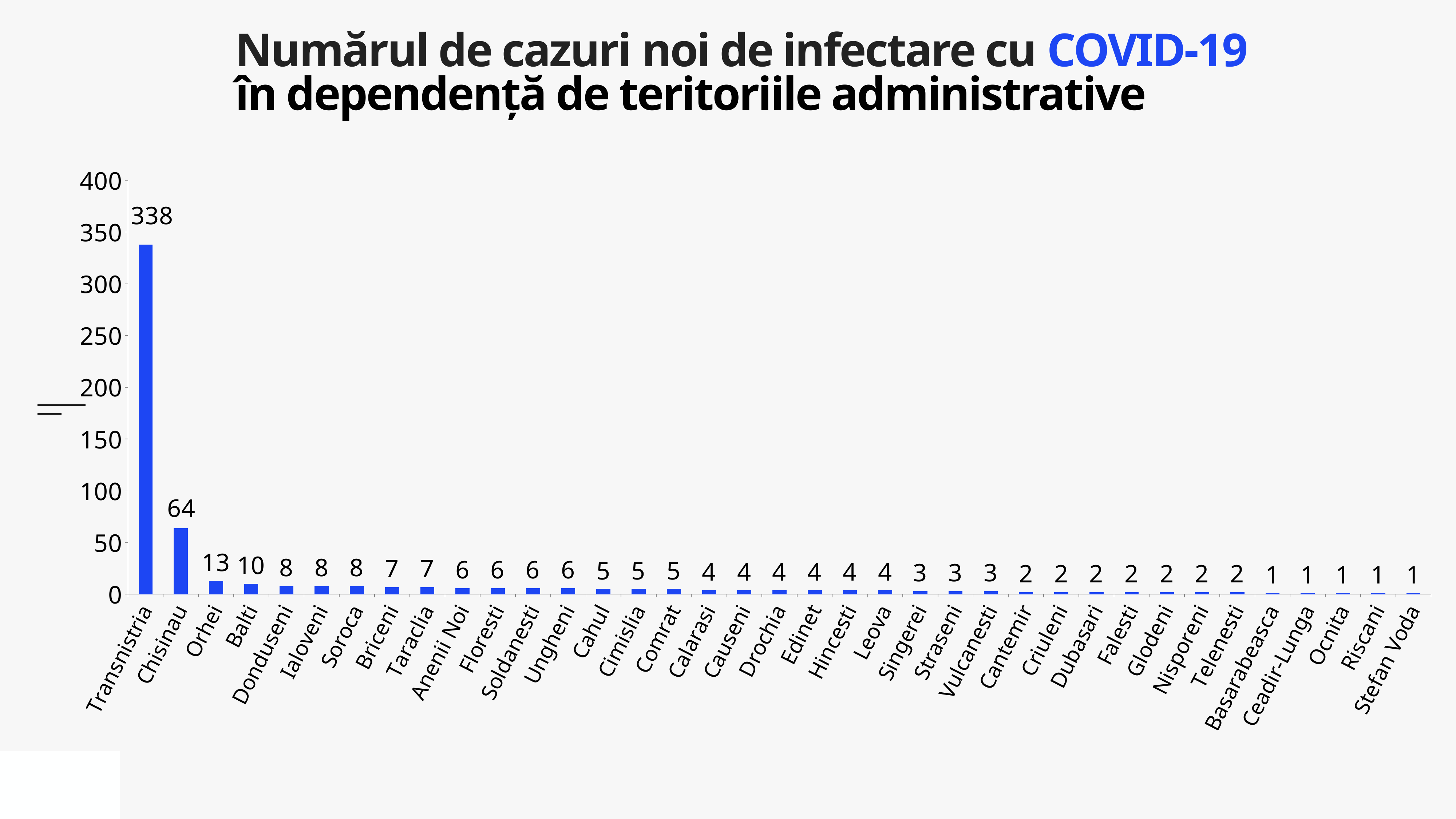
Which territory has the highest number of new cases? Transnistria What is the value for Balti? 10 What is the value for Orhei? 13 What is the value for Transnistria? 338 What kind of chart is shown on the slide? bar chart What is the difference between the values for Transnistria and Chisinau? 274 How many territories are shown on the x axis? 37 What is the difference between the values for Orhei and Balti? 3 Which is larger, the value for Chisinau or the value for Orhei? Chisinau Do the values rise or fall from left to right along the x axis? fall Is the value for Transnistria greater or less than 300? greater What is the value for Chisinau? 64